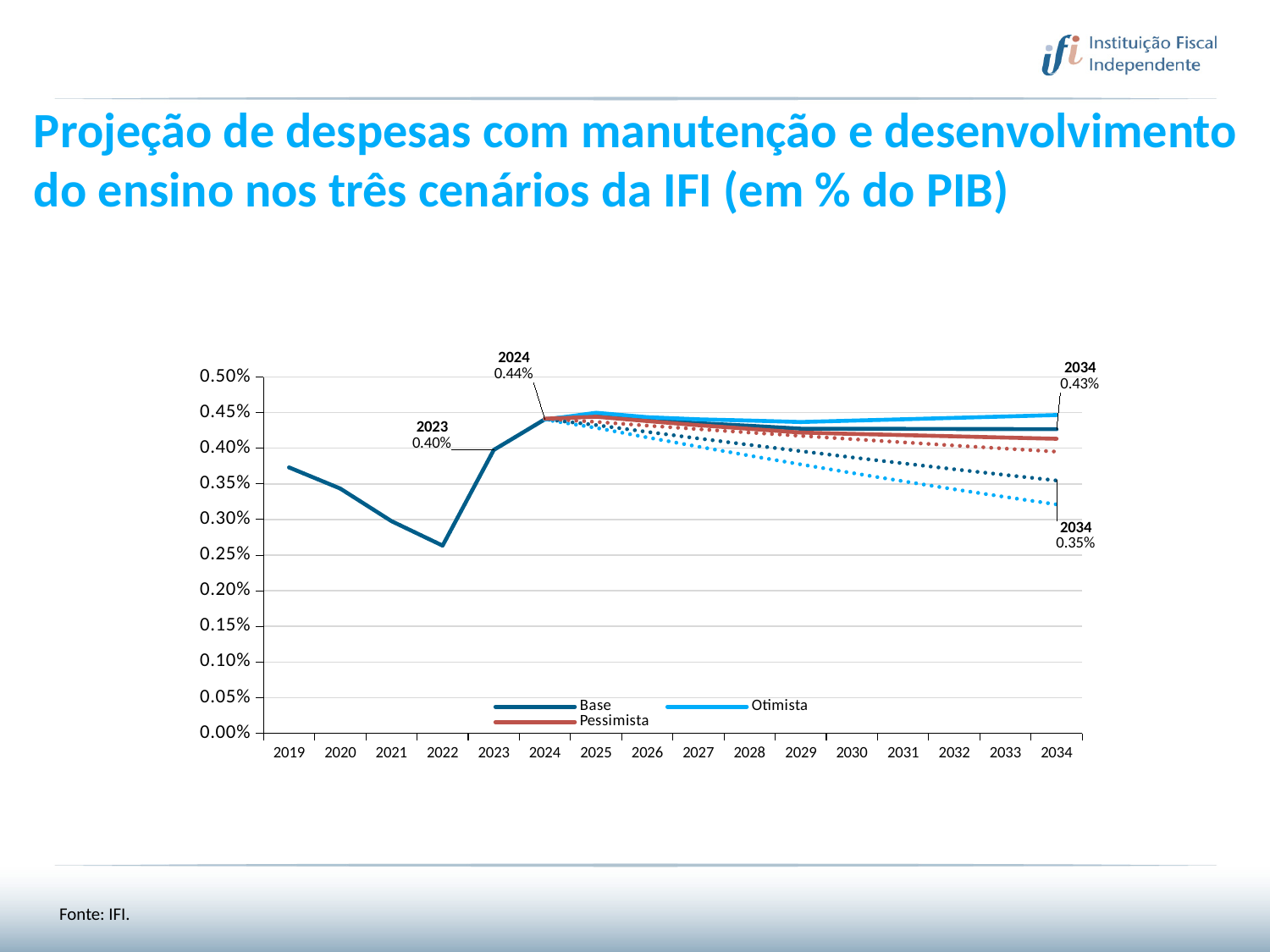
What type of chart is shown on the slide? Line chart Is the value for 2019 greater or less than 0.35%? greater How many years are shown on the x axis? 16 How many series does the legend list? 3 In which year does the line reach its lowest point? 2022 What are the three series named in the legend? Base, Otimista, Pessimista Do the values rise or fall from 2019 to 2022? Fall What value is labelled for 2024? 0.44% What value is labelled for 2023? 0.40% Is the value for 2022 greater or less than 0.30%? less What is the difference between the labelled values for 2024 and 2023? 0.04 percentage points Which is larger, the labelled value for 2023 or for 2024? 2024